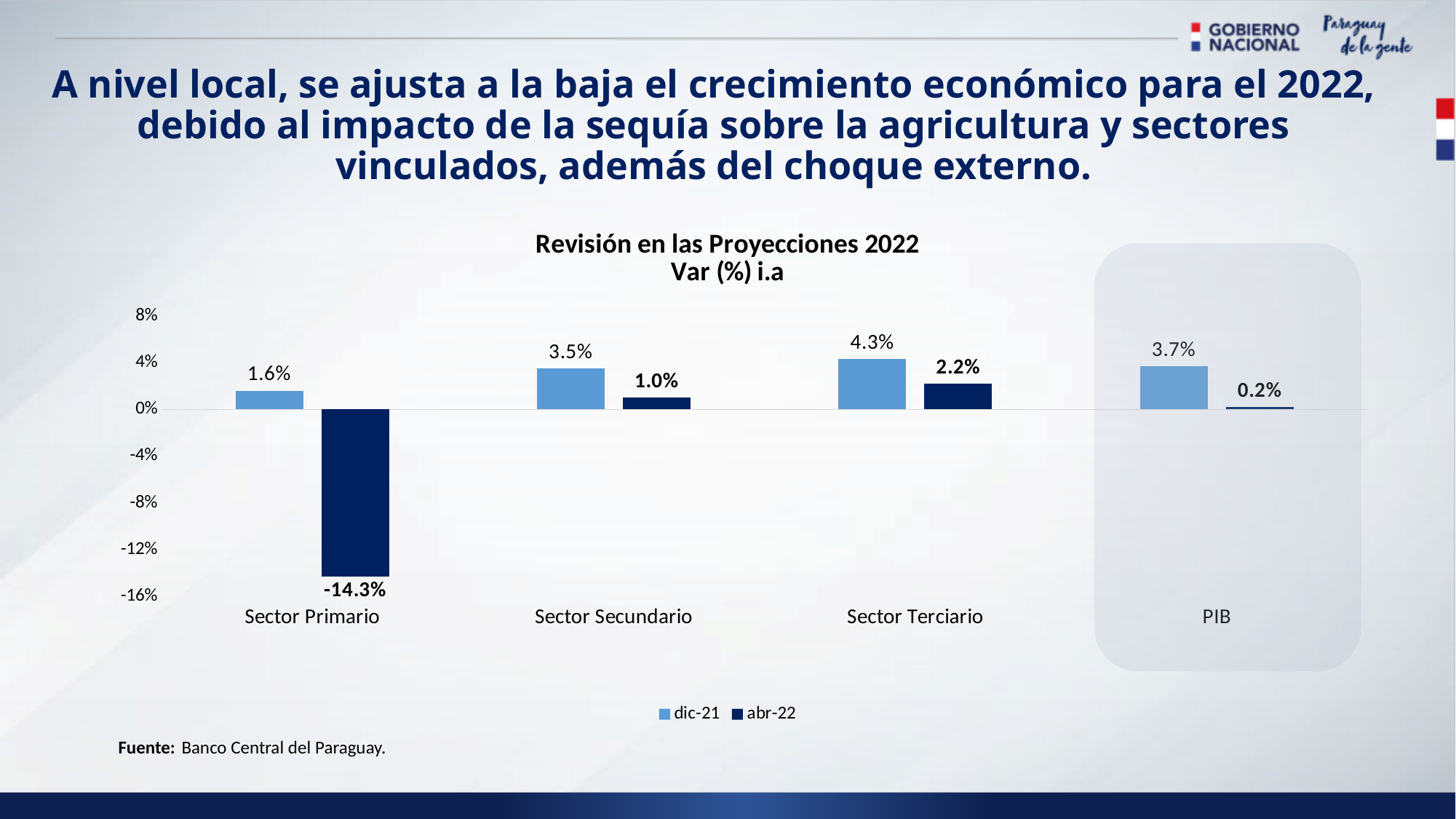
Which is larger for Sector Secundario, the dic-21 value or the abr-22 value? dic-21 What kind of chart is shown on the slide? Bar chart What is the abr-22 value for Sector Primario? -14.3% What is the difference between the dic-21 and abr-22 values for PIB? 3.5% What is the abr-22 value for PIB? 0.2% Which category has the highest dic-21 value? Sector Terciario How many categories are shown on the x axis? 4 Which category has the lowest abr-22 value? Sector Primario What is the title of the chart? Revisión en las Proyecciones 2022 Var (%) i.a What is the dic-21 value for Sector Terciario? 4.3% How many series does the legend list? 2 What is the dic-21 value for Sector Secundario? 3.5%